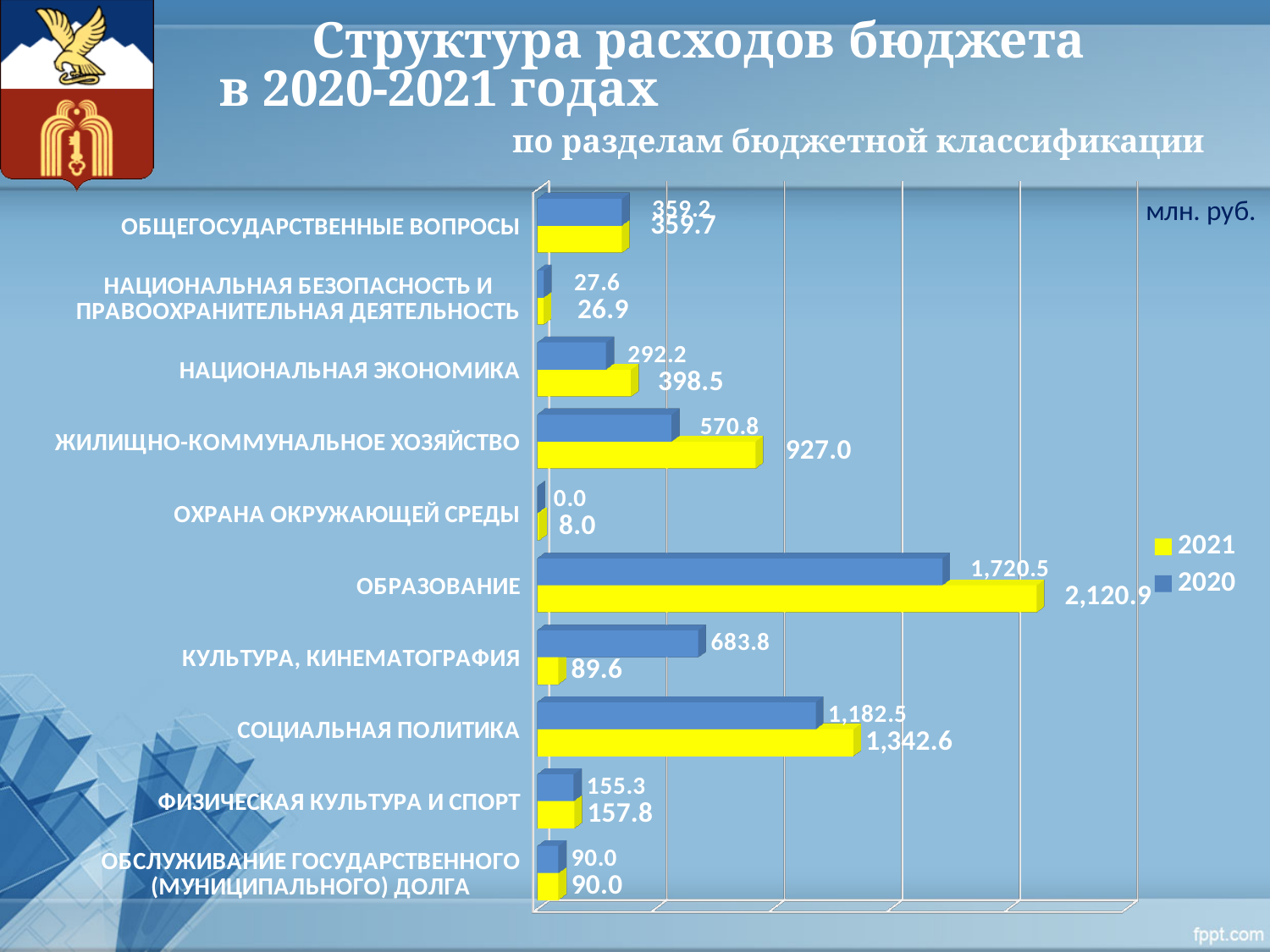
What is the 2021 value for ОБРАЗОВАНИЕ? 2,120.9 What is the 2021 value for КУЛЬТУРА, КИНЕМАТОГРАФИЯ? 89.6 Which category has the lowest 2020 value? ОХРАНА ОКРУЖАЮЩЕЙ СРЕДЫ For НАЦИОНАЛЬНАЯ ЭКОНОМИКА, which year has the larger value, 2020 or 2021? 2021 How many series does the legend list? 2 What kind of chart is shown on the slide? Bar chart By how much did the value for ОБРАЗОВАНИЕ increase from 2020 to 2021? 400.4 How many categories are shown in the chart? 10 What is the 2020 value for ЖИЛИЩНО-КОММУНАЛЬНОЕ ХОЗЯЙСТВО? 570.8 Which category has the highest 2021 value? ОБРАЗОВАНИЕ What is the 2020 value for СОЦИАЛЬНАЯ ПОЛИТИКА? 1,182.5 What is the difference between the 2020 and 2021 values for КУЛЬТУРА, КИНЕМАТОГРАФИЯ? 594.2